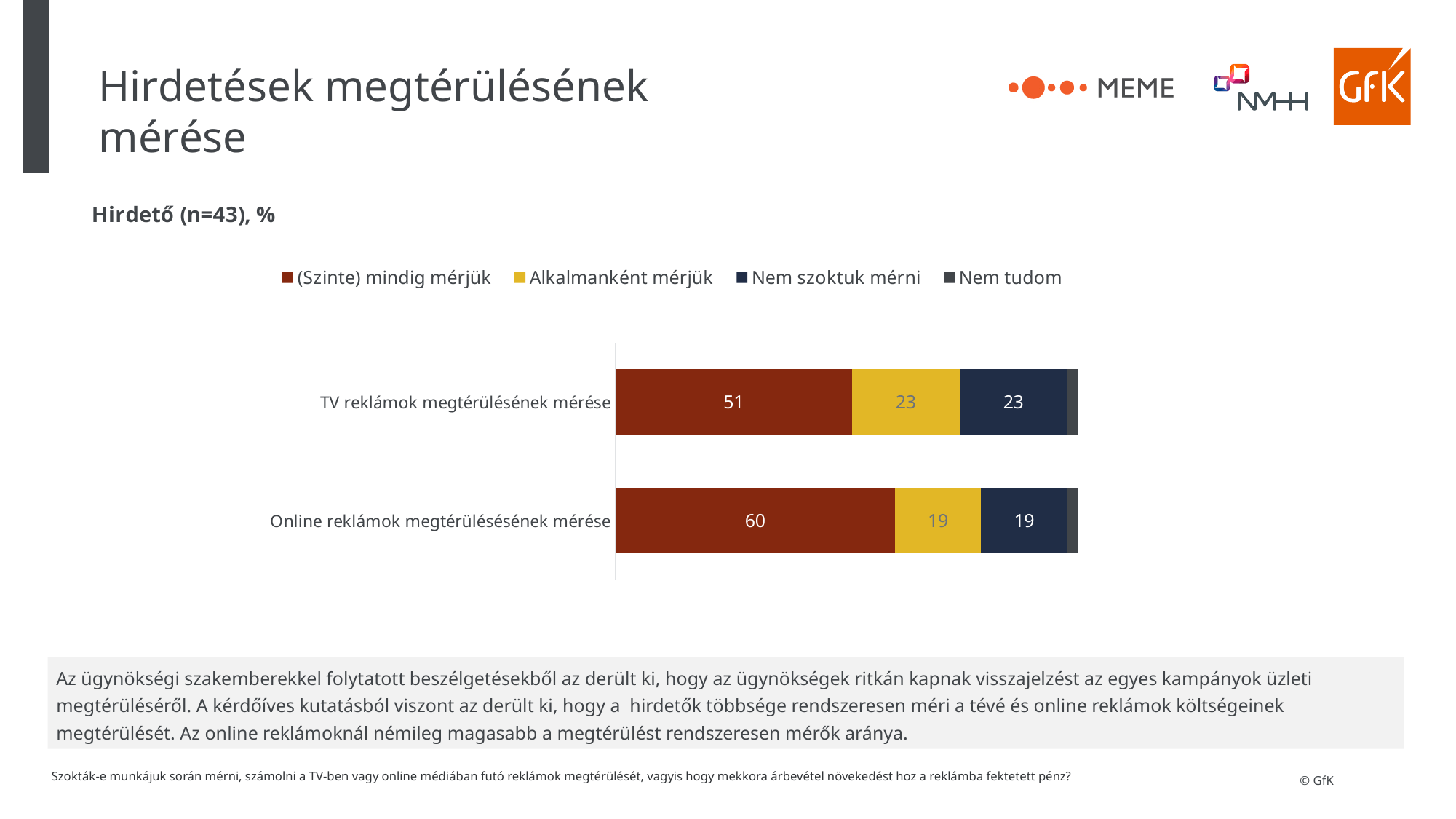
How many series does the legend list? 4 What is the value of "Alkalmanként mérjük" for "TV reklámok megtérülésének mérése"? 23 What kind of chart is shown on the slide? stacked bar chart What is the value of "(Szinte) mindig mérjük" for "Online reklámok megtérülésésének mérése"? 60 Which category has the higher value for "(Szinte) mindig mérjük"? Online reklámok megtérülésésének mérése What is the title shown above the chart? Hirdető (n=43), % What is the value of "Nem szoktuk mérni" for "Online reklámok megtérülésésének mérése"? 19 What is the value of "(Szinte) mindig mérjük" for "TV reklámok megtérülésének mérése"? 51 What is the difference between the "Nem szoktuk mérni" values for TV ads and online ads? 4 How many categories are plotted on the chart? 2 What is the difference between the "(Szinte) mindig mérjük" values for online and TV ads? 9 Is the "Alkalmanként mérjük" value larger for TV ads or for online ads? TV reklámok megtérülésének mérése